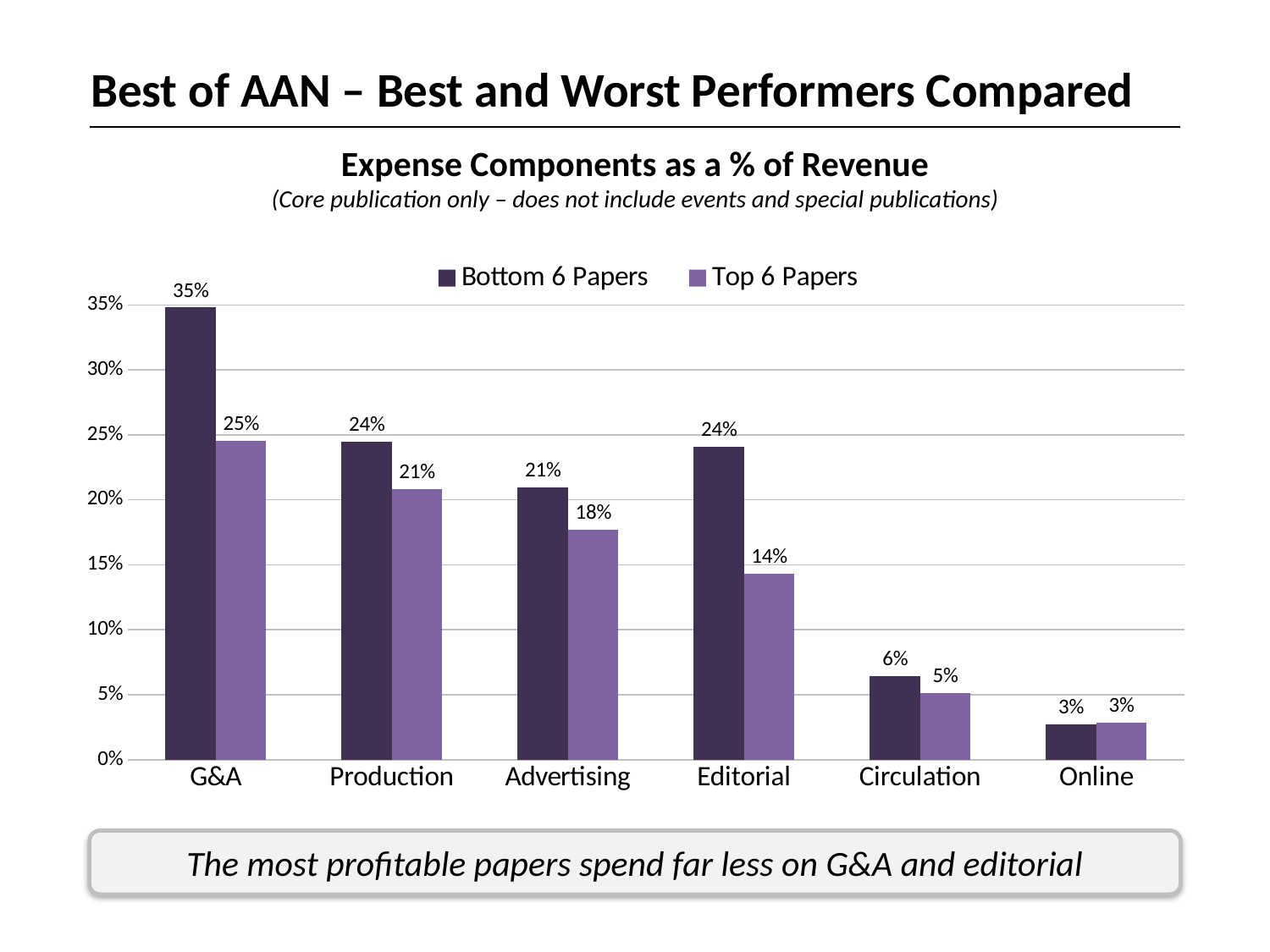
What is the difference between the Bottom 6 Papers and Top 6 Papers values for G&A? 10% What kind of chart is shown on the slide? Bar chart What is the G&A value for Bottom 6 Papers? 35% How many expense categories are shown on the x axis? 6 How many series does the legend list? 2 Which category has the lowest value for Top 6 Papers? Online What is the Editorial value for Top 6 Papers? 14% What is the title of the chart? Expense Components as a % of Revenue Which category has the highest value for Bottom 6 Papers? G&A For Production, which series has the larger value, Bottom 6 Papers or Top 6 Papers? Bottom 6 Papers What is the Advertising value for Top 6 Papers? 18% What is the difference between the Bottom 6 Papers and Top 6 Papers values for Editorial? 10%